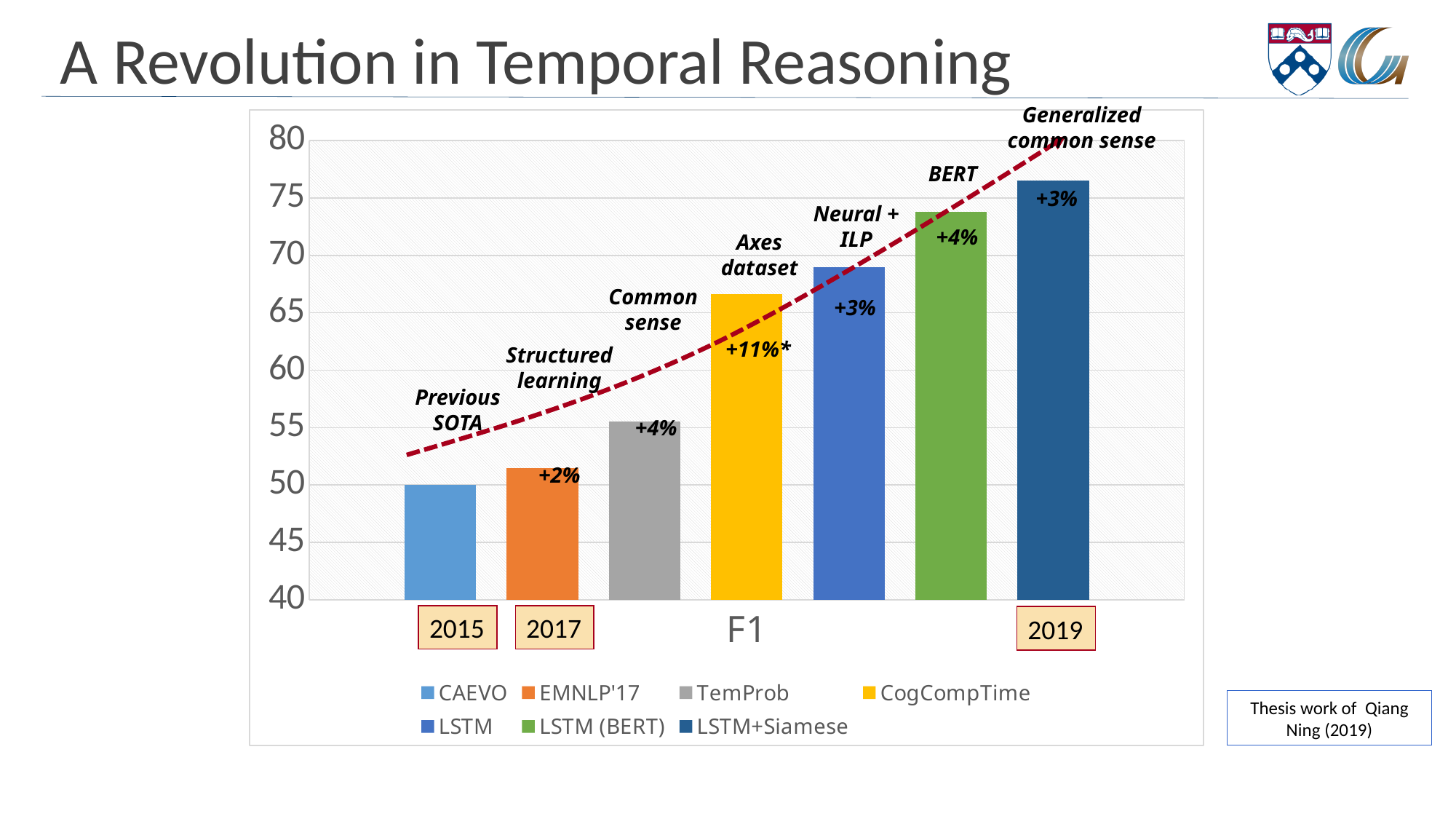
Is the F1 value for LSTM+Siamese greater or less than 75? greater What improvement label is printed on the CogCompTime bar? +11%* What is the title of the slide containing the chart? A Revolution in Temporal Reasoning Which series has the highest F1 bar? LSTM+Siamese Which bar is taller, LSTM (BERT) or LSTM? LSTM (BERT) What kind of chart is shown on the slide? bar chart Which series has the lowest F1 bar? CAEVO What improvement label is printed on the EMNLP'17 bar? +2% Is the F1 value for TemProb greater or less than 60? less How many series does the legend list? 7 Is the F1 value for CogCompTime greater or less than 65? greater What is the F1 value of the CAEVO bar? 50